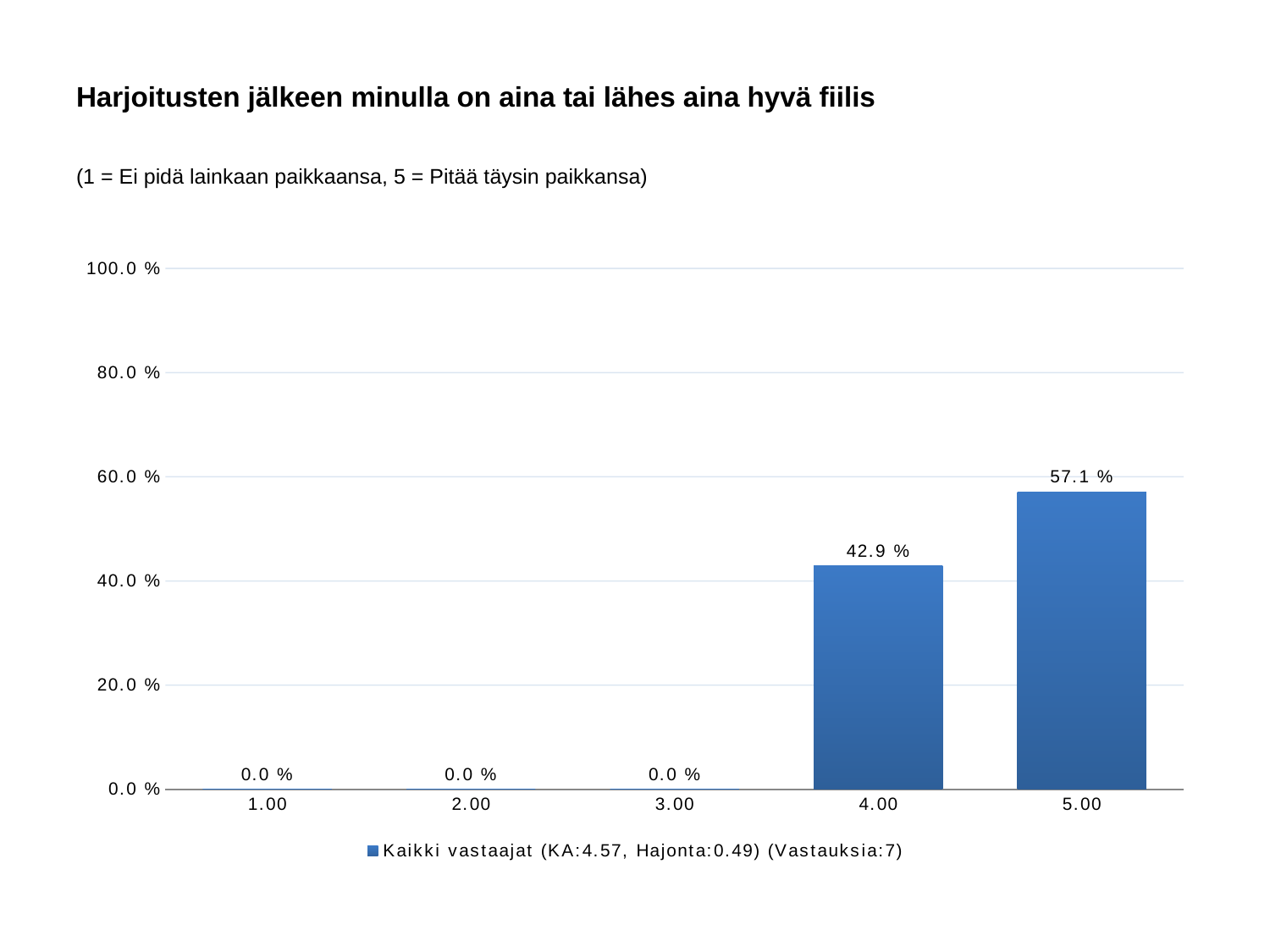
What is the value for category 4.00? 42.9 % What is the value for category 1.00? 0.0 % What kind of chart is shown? bar chart What is the title of the chart? Harjoitusten jälkeen minulla on aina tai lähes aina hyvä fiilis Is the value for 4.00 greater or less than 40.0 %? greater How many categories are shown on the x axis? 5 Is the value for 5.00 greater or less than 60.0 %? less Which category has the highest value? 5.00 How many series does the legend list? 1 What is the value for category 5.00? 57.1 % What is the difference between the values for 5.00 and 4.00? 14.2 % Which is larger, the value for 4.00 or the value for 5.00? 5.00